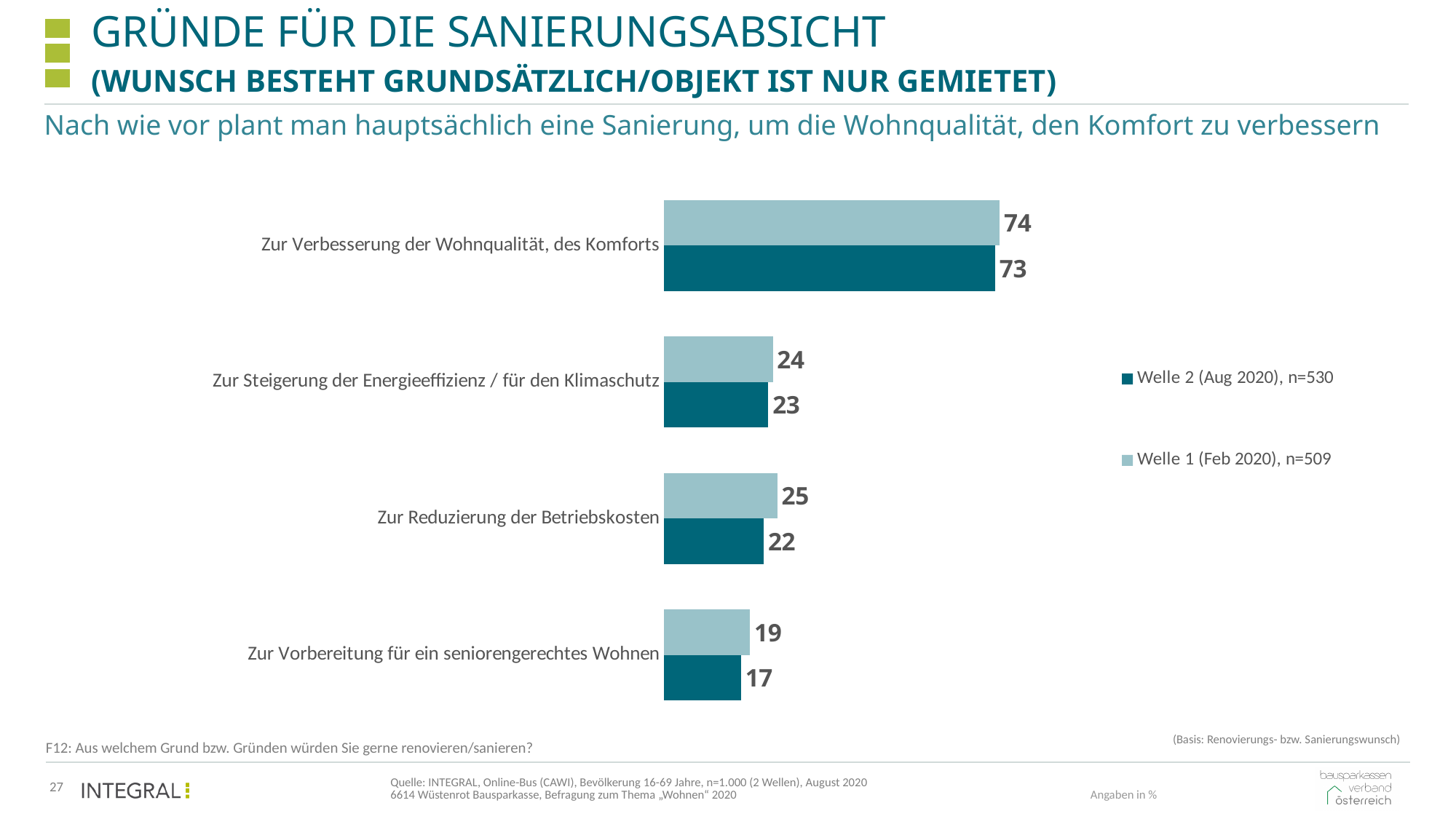
Which category has the lowest value in Welle 2 (Aug 2020)? Zur Vorbereitung für ein seniorengerechtes Wohnen What is the sample size (n) given in the legend for Welle 2 (Aug 2020)? n=530 What is the value for "Zur Verbesserung der Wohnqualität, des Komforts" in Welle 2 (Aug 2020)? 73 How many categories are shown in the chart? 4 What is the value for "Zur Vorbereitung für ein seniorengerechtes Wohnen" in Welle 2 (Aug 2020)? 17 What is the difference between the Welle 1 and Welle 2 values for "Zur Reduzierung der Betriebskosten"? 3 What kind of chart is shown on the slide? Bar chart Which category has the highest value in Welle 1 (Feb 2020)? Zur Verbesserung der Wohnqualität, des Komforts What is the difference between the Welle 1 and Welle 2 values for "Zur Verbesserung der Wohnqualität, des Komforts"? 1 How many series does the legend list? 2 Which is larger for "Zur Steigerung der Energieeffizienz / für den Klimaschutz": the Welle 1 (Feb 2020) value or the Welle 2 (Aug 2020) value? Welle 1 (Feb 2020) What is the value for "Zur Reduzierung der Betriebskosten" in Welle 1 (Feb 2020)? 25